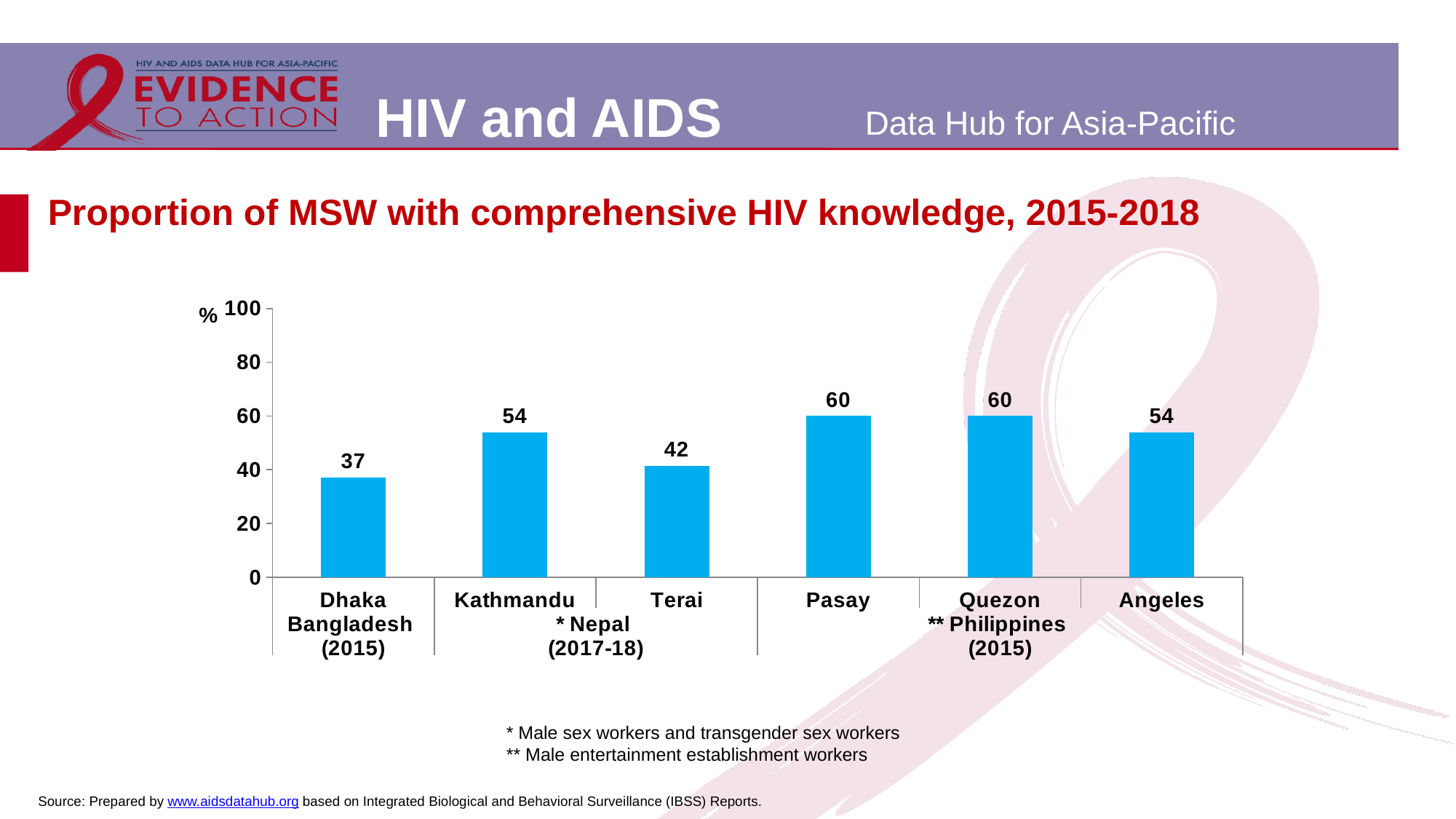
What is the difference between the values for Pasay and Dhaka? 23 What value is shown for Terai? 42 What is the proportion of MSW with comprehensive HIV knowledge in Dhaka, Bangladesh? 37 What value is shown for Pasay? 60 Which has a higher value, Terai or Angeles? Angeles What type of chart is shown on the slide? Bar chart What is the difference between the values for Kathmandu and Terai? 12 Which city has the lowest proportion of MSW with comprehensive HIV knowledge? Dhaka How many cities are shown in the chart? 6 What value is shown for Kathmandu? 54 What is the title of the chart? Proportion of MSW with comprehensive HIV knowledge, 2015-2018 Is the value for Dhaka greater or less than 40? less